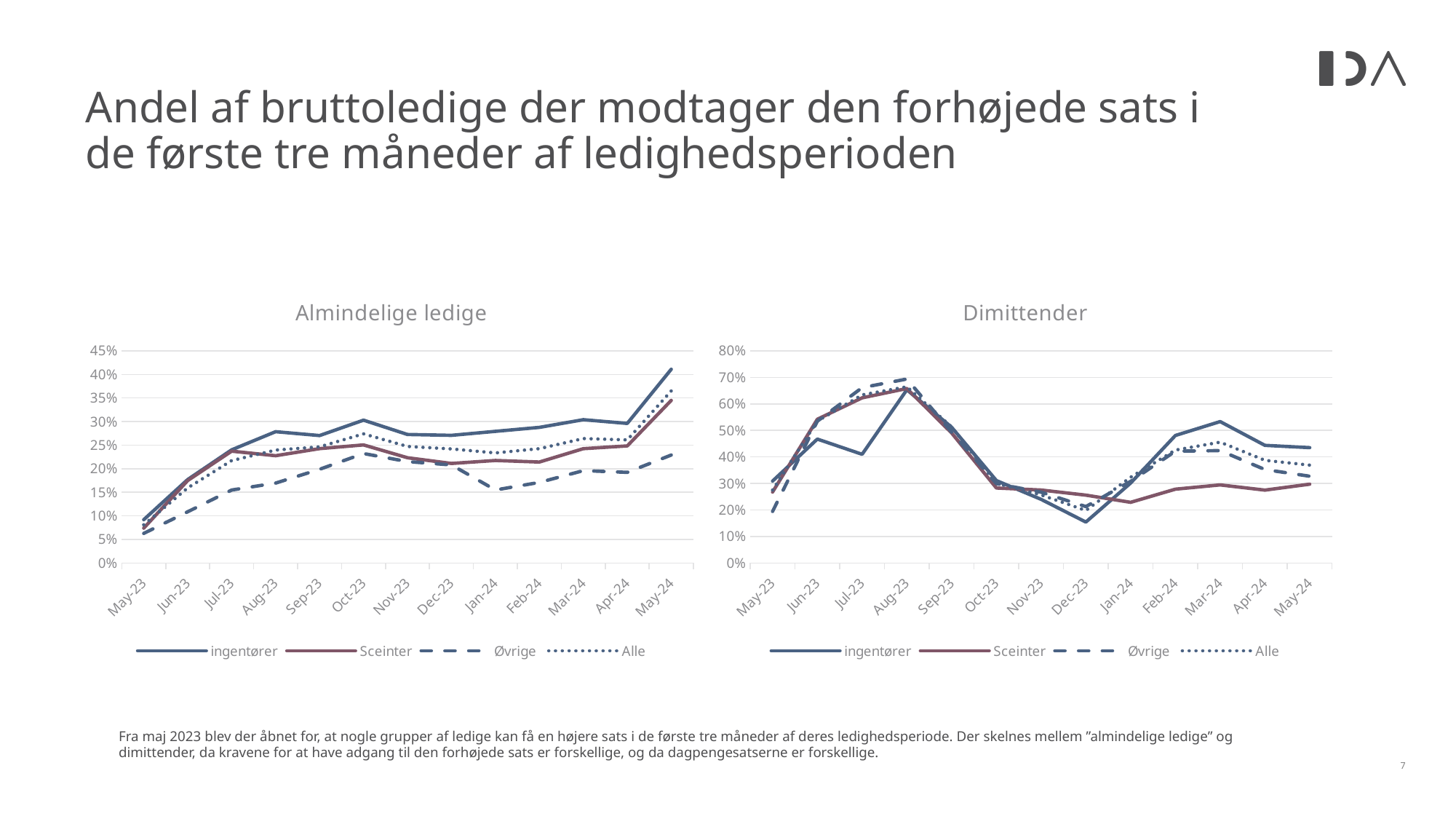
Which series is drawn with a dotted line in the "Almindelige ledige" chart? Alle In the "Dimittender" chart, is the value for ingentører in Dec-23 greater or less than 20%? less In the "Almindelige ledige" chart, is the value for Øvrige in Jan-24 greater or less than 20%? less In the "Dimittender" chart, which is larger in Dec-23: Sceinter or ingentører? Sceinter In the "Almindelige ledige" chart, which series has the highest value in May-24? ingentører In the "Almindelige ledige" chart, is the value for ingentører in May-24 greater or less than 40%? greater How many series does the legend of the "Dimittender" chart list? 4 What kind of chart is the "Almindelige ledige" chart? line chart In the "Dimittender" chart, does the ingentører line rise or fall from Aug-23 to Dec-23? fall How many months are shown on the x axis of the "Almindelige ledige" chart? 13 In the "Dimittender" chart, which series has the lowest value in Dec-23? ingentører